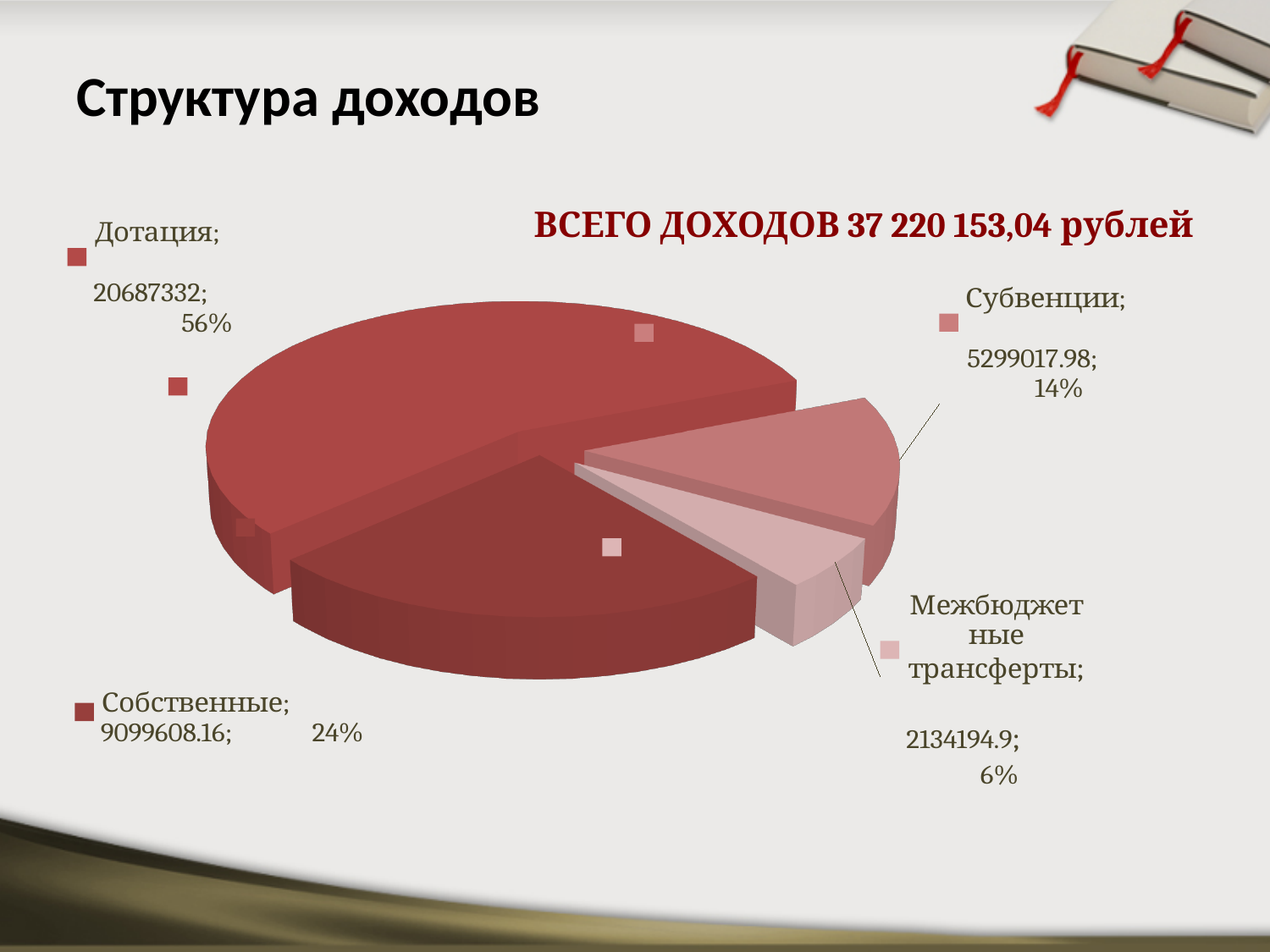
What is the value shown for Собственные? 9099608.16 What kind of chart is shown on the slide? pie chart What is the value shown for Дотация? 20687332 What share of the pie does Собственные represent? 24% What is the title of the slide containing the chart? Структура доходов Which category has the largest slice of the pie? Дотация What is the value shown for Межбюджетные трансферты? 2134194.9 What share of the pie does Дотация represent? 56% What is the value shown for Субвенции? 5299017.98 Which category has the smallest slice of the pie? Межбюджетные трансферты How many slices does the pie chart have? 4 Which is larger, the share for Субвенции or the share for Собственные? Собственные